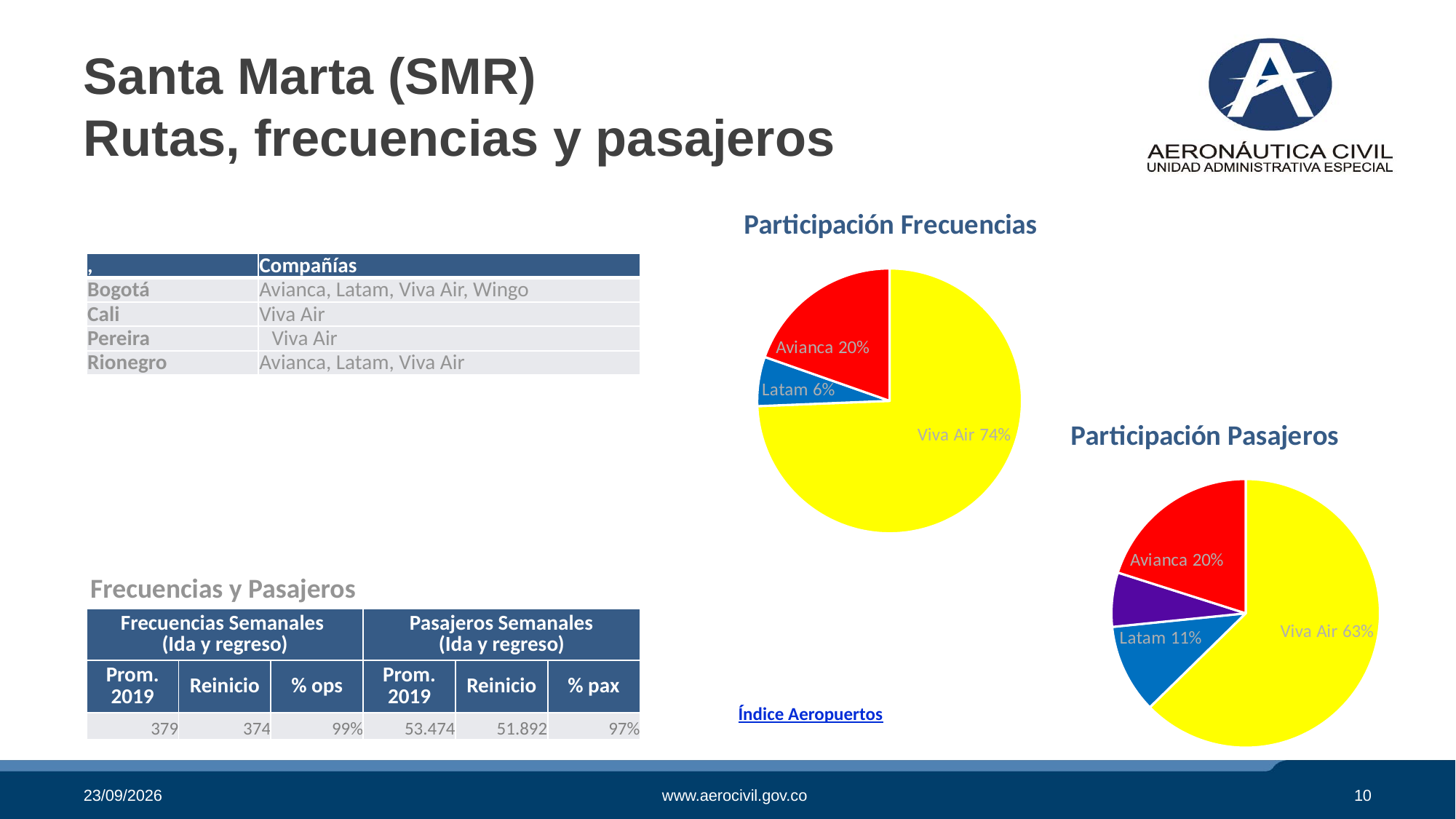
In the Participación Frecuencias chart, which airline has the largest share? Viva Air In the Participación Pasajeros chart, which labelled airline has the largest share? Viva Air How many slices does the Participación Frecuencias pie chart have? 3 In the Participación Frecuencias chart, what share does Avianca have? 20% In the Participación Frecuencias chart, what is the difference between Viva Air's share and Avianca's share? 54% In the Participación Pasajeros chart, what share does Latam have? 11% In the Participación Pasajeros chart, which is larger, Avianca's share or Latam's share? Avianca In the Participación Frecuencias chart, what share does Viva Air have? 74% In the Participación Frecuencias chart, what share does Latam have? 6% In the Participación Frecuencias chart, which airline has the smallest share? Latam What kind of chart is Participación Frecuencias? Pie chart In the Participación Pasajeros chart, what share does Viva Air have? 63%